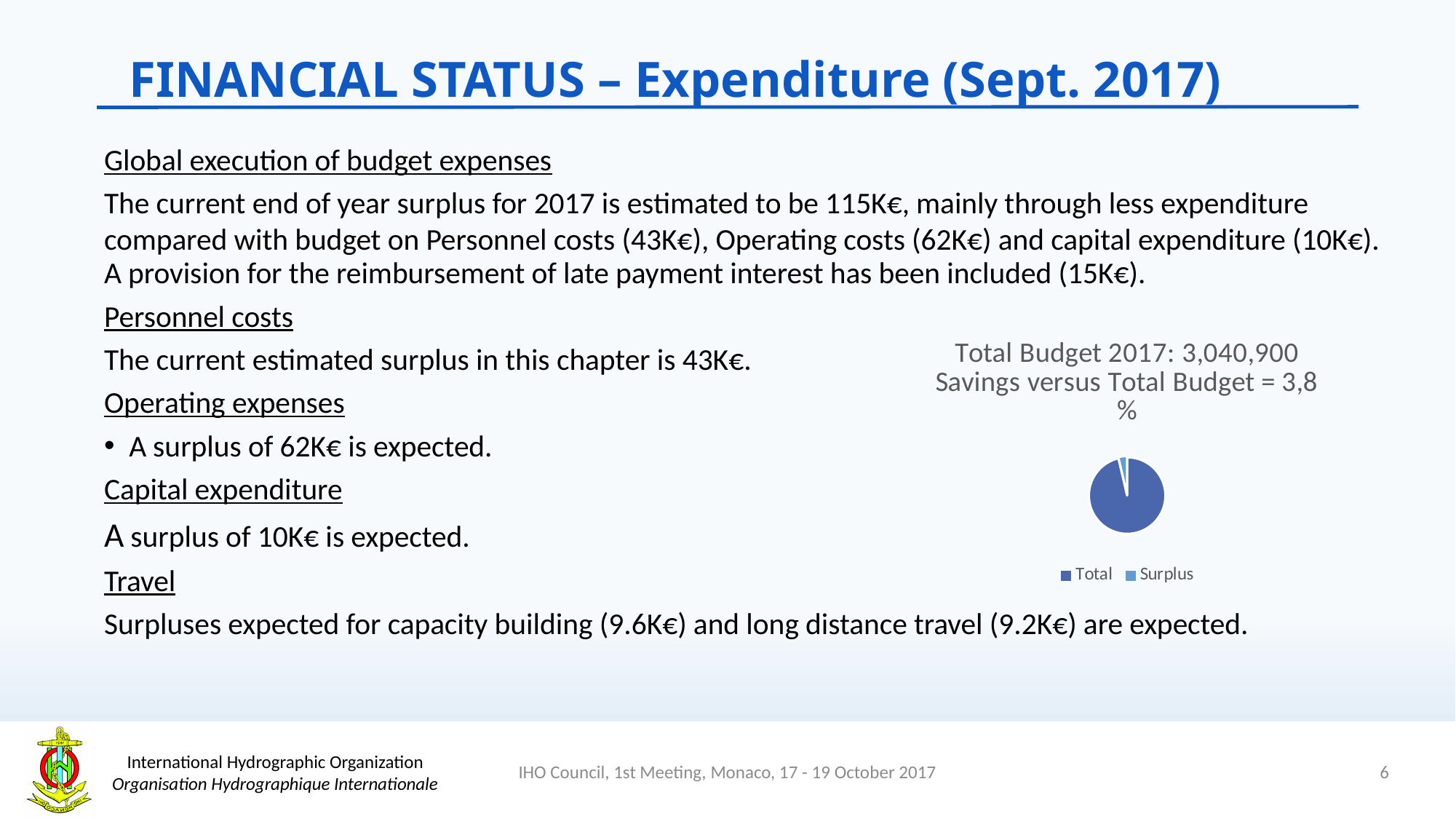
In the pie chart, which is larger, Total or Surplus? Total What kind of chart is shown on the slide? pie chart Which slice of the pie chart is the smallest? Surplus What are the two legend entries of the pie chart? Total, Surplus According to the pie chart title, what are the savings versus the total budget as a percentage? 3,8 % How many entries does the legend of the pie chart list? 2 Which slice of the pie chart is the largest? Total According to the pie chart title, what is the Total Budget 2017? 3,040,900 How many slices does the pie chart have? 2